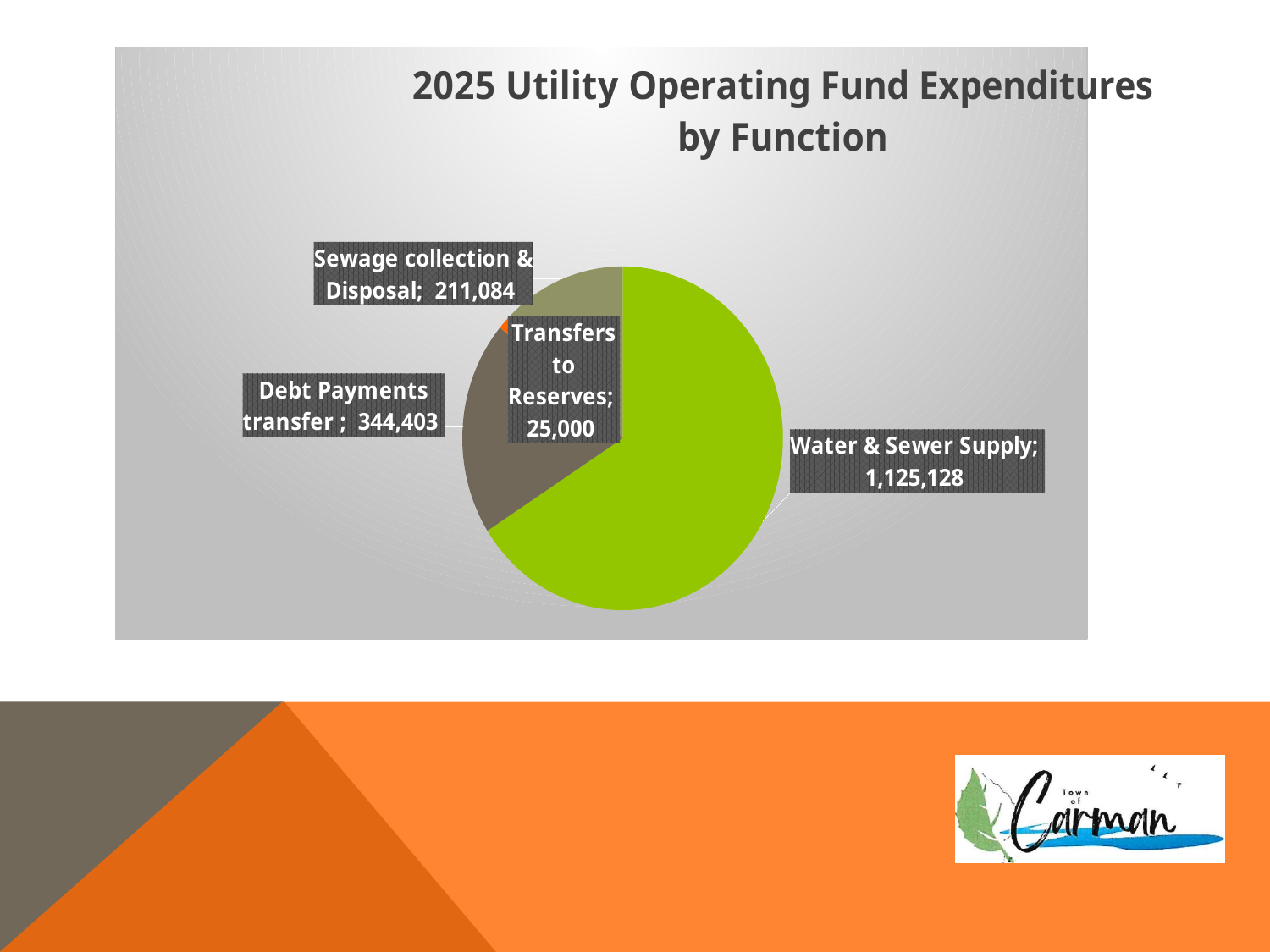
What is the total of all four categories in the pie chart? 1,705,615 How many categories are shown in the pie chart? 4 What is the value for Sewage collection & Disposal? 211,084 Which category has the largest expenditure? Water & Sewer Supply Which category has the smallest expenditure? Transfers to Reserves Which is larger, Debt Payments transfer or Sewage collection & Disposal? Debt Payments transfer What is the difference between Water & Sewer Supply and Debt Payments transfer? 780,725 What is the value for Transfers to Reserves? 25,000 What is the value for Debt Payments transfer? 344,403 What type of chart is shown on the slide? Pie chart What is the title of the chart? 2025 Utility Operating Fund Expenditures by Function What is the value for Water & Sewer Supply? 1,125,128